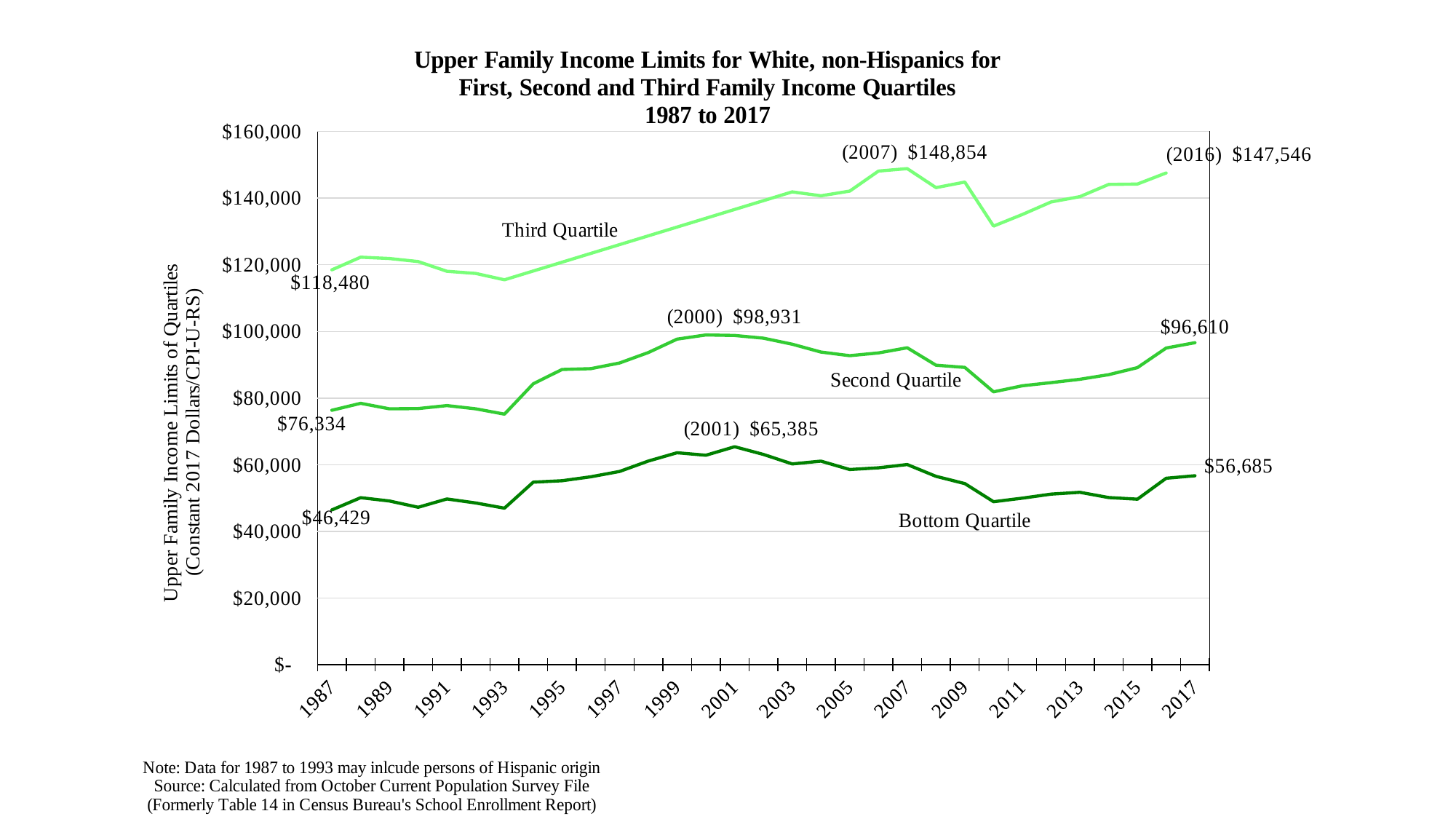
By how much did the Third Quartile upper income limit increase from 1987 to 2007? $30,374 What is the Third Quartile upper income limit in 2007? $148,854 What kind of chart is shown on the slide? line chart Does the Third Quartile line rise or fall between 1993 and 2007? rise What is the Bottom Quartile upper income limit in 1987? $46,429 What is the difference between the Bottom Quartile upper income limit in 2017 and in 1987? $10,256 How many quartile series are plotted on the chart? 3 Is the Third Quartile value for 2010 greater or less than $140,000? less Which year has the higher Second Quartile upper income limit, 2000 or 2017? 2000 What is the Second Quartile upper income limit in 2000? $98,931 What is the Bottom Quartile upper income limit in 2001? $65,385 What is the Third Quartile upper income limit in 2016? $147,546